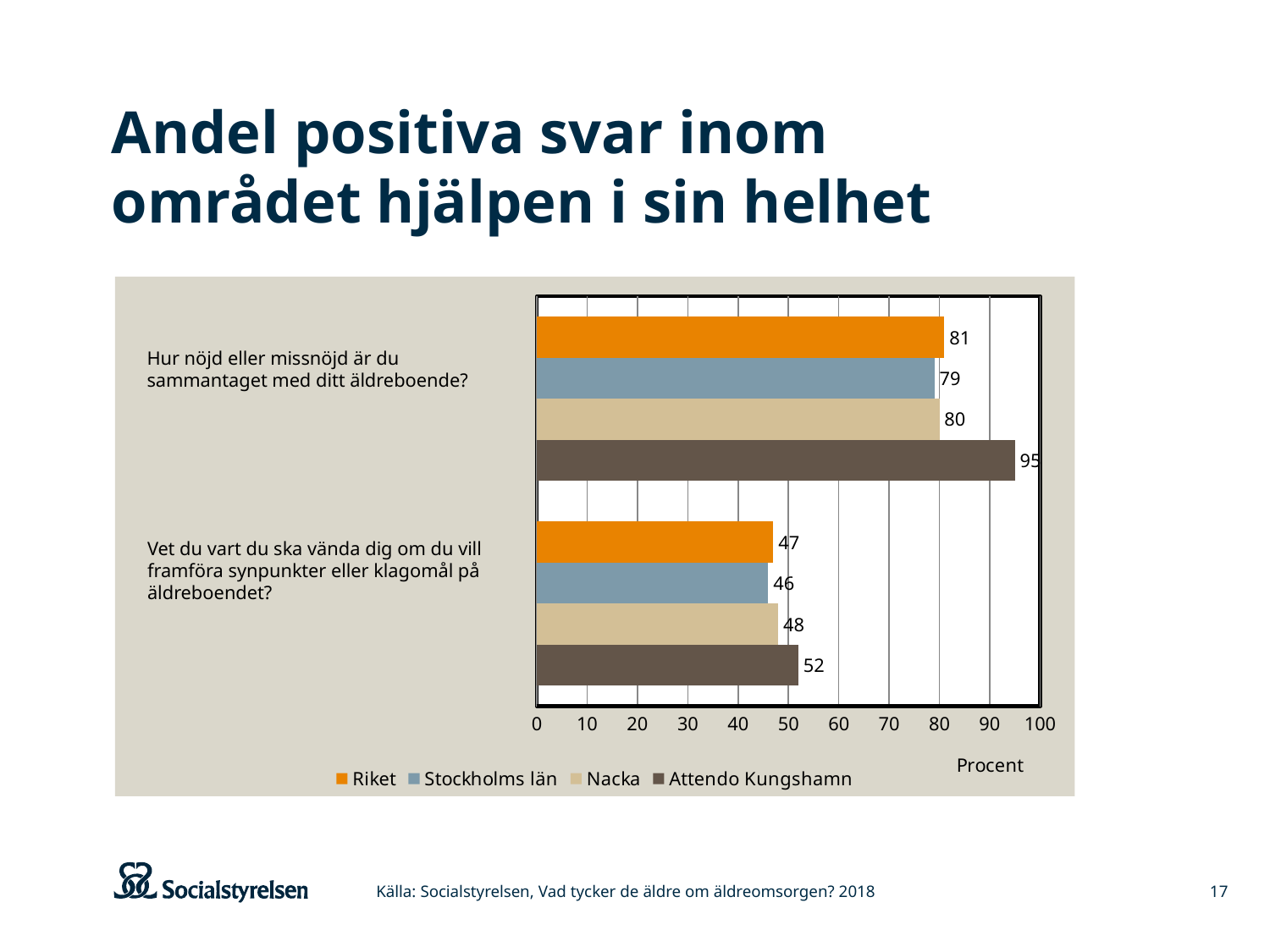
What is the difference between Attendo Kungshamn and Nacka on the question "Vet du vart du ska vända dig om du vill framföra synpunkter eller klagomål på äldreboendet?"? 4 Which series has the lowest value on the question "Vet du vart du ska vända dig om du vill framföra synpunkter eller klagomål på äldreboendet?"? Stockholms län What is the value for Riket on the question "Vet du vart du ska vända dig om du vill framföra synpunkter eller klagomål på äldreboendet?"? 47 What is the value for Attendo Kungshamn on the question "Hur nöjd eller missnöjd är du sammantaget med ditt äldreboende?"? 95 What unit is shown on the horizontal axis of the chart? Procent What is the value for Nacka on the question "Vet du vart du ska vända dig om du vill framföra synpunkter eller klagomål på äldreboendet?"? 48 How many series does the legend list? 4 Which series has the highest value on the question "Hur nöjd eller missnöjd är du sammantaget med ditt äldreboende?"? Attendo Kungshamn What is the difference between Attendo Kungshamn and Riket on the question "Hur nöjd eller missnöjd är du sammantaget med ditt äldreboende?"? 14 What is the value for Stockholms län on the question "Hur nöjd eller missnöjd är du sammantaget med ditt äldreboende?"? 79 Which is larger on the question "Hur nöjd eller missnöjd är du sammantaget med ditt äldreboende?": Riket or Nacka? Riket What kind of chart is shown on the slide? Bar chart